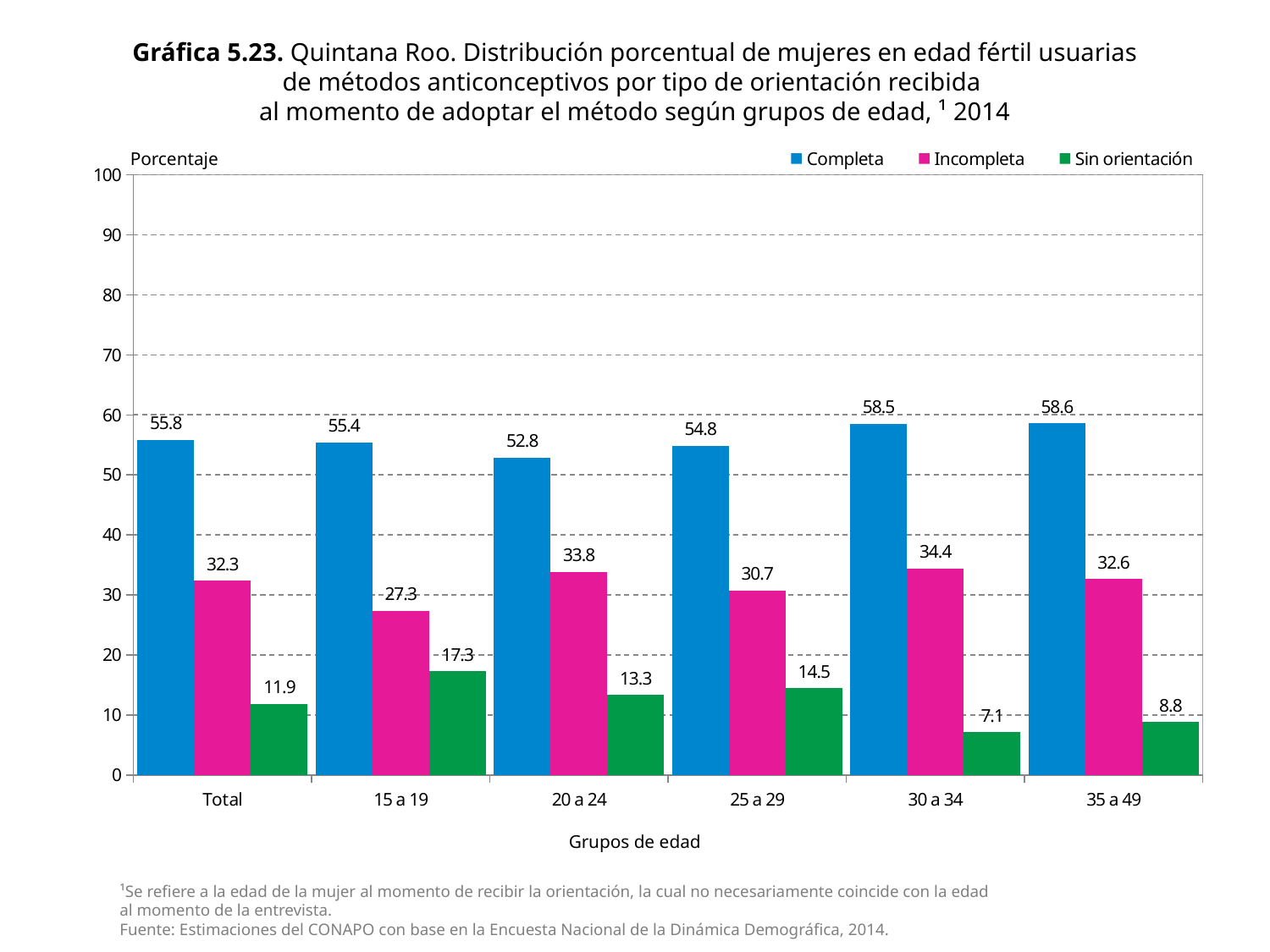
How many age group categories are shown on the x axis? 6 What is the value for Completa in the 20 a 24 age group? 52.8 How many series does the legend list? 3 Is the value for Completa in the 30 a 34 age group greater or less than 50? greater Which age group has the highest value for Completa? 35 a 49 What is the value for Sin orientación in the 15 a 19 age group? 17.3 Which age group has the lowest value for Sin orientación? 30 a 34 What is the value for Incompleta for Total? 32.3 Which age group has the lowest value for Incompleta? 15 a 19 Which is larger: Incompleta for 20 a 24 or Incompleta for 30 a 34? Incompleta for 30 a 34 What kind of chart is shown on the slide? Bar chart What is the difference between the Completa and Incompleta values in the 25 a 29 age group? 24.1